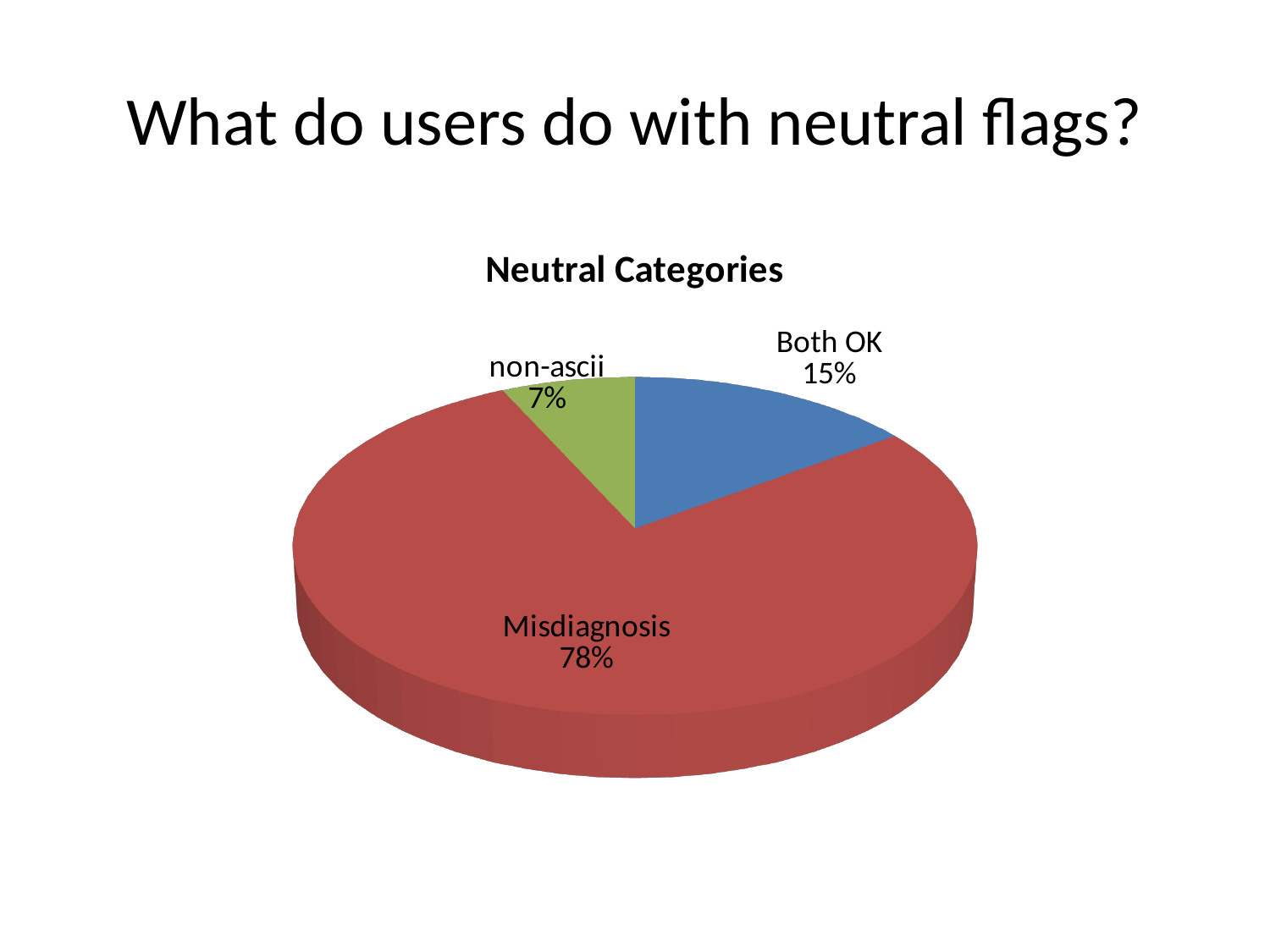
What is the title of the chart? Neutral Categories Which category has the largest slice of the pie? Misdiagnosis What type of chart is shown on the slide? pie chart What colour is the Misdiagnosis slice? red Which is larger, the Both OK slice or the non-ascii slice? Both OK What is the difference in percentage points between Both OK and non-ascii? 8 Which category has the smallest slice of the pie? non-ascii What share of the pie does Both OK take? 15% How many categories are shown in the pie chart? 3 What is the difference in percentage points between Misdiagnosis and Both OK? 63 What share of the pie does Misdiagnosis take? 78% What share of the pie does non-ascii take? 7%